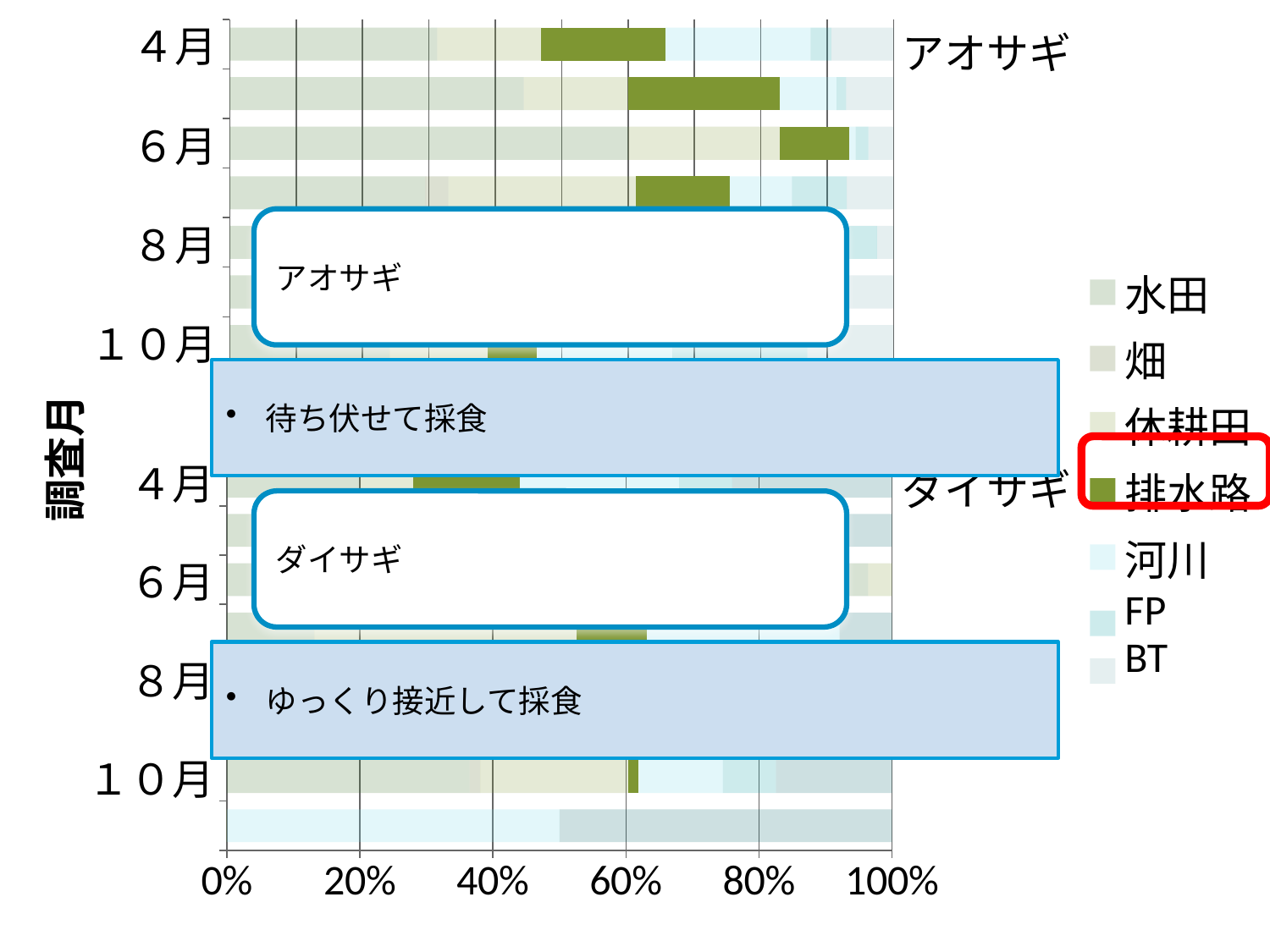
What is the maximum value shown on the horizontal axis? 100% Which is larger: the 排水路 segment for アオサギ in 6月 or for ダイサギ in 10月? アオサギ in 6月 How many series does the legend list? 7 Which legend entry is highlighted with a red box? 排水路 For アオサギ in 4月, does the 排水路 segment end at a value greater or less than 60%? greater Which species' bars are shown in the upper half of the chart? アオサギ What is the label on the vertical axis? 調査月 What kind of chart is shown on the slide? stacked bar chart For アオサギ in 6月, does the 排水路 segment end at a value greater or less than 80%? greater For ダイサギ in 4月, does the 排水路 segment end at a value greater or less than 60%? less